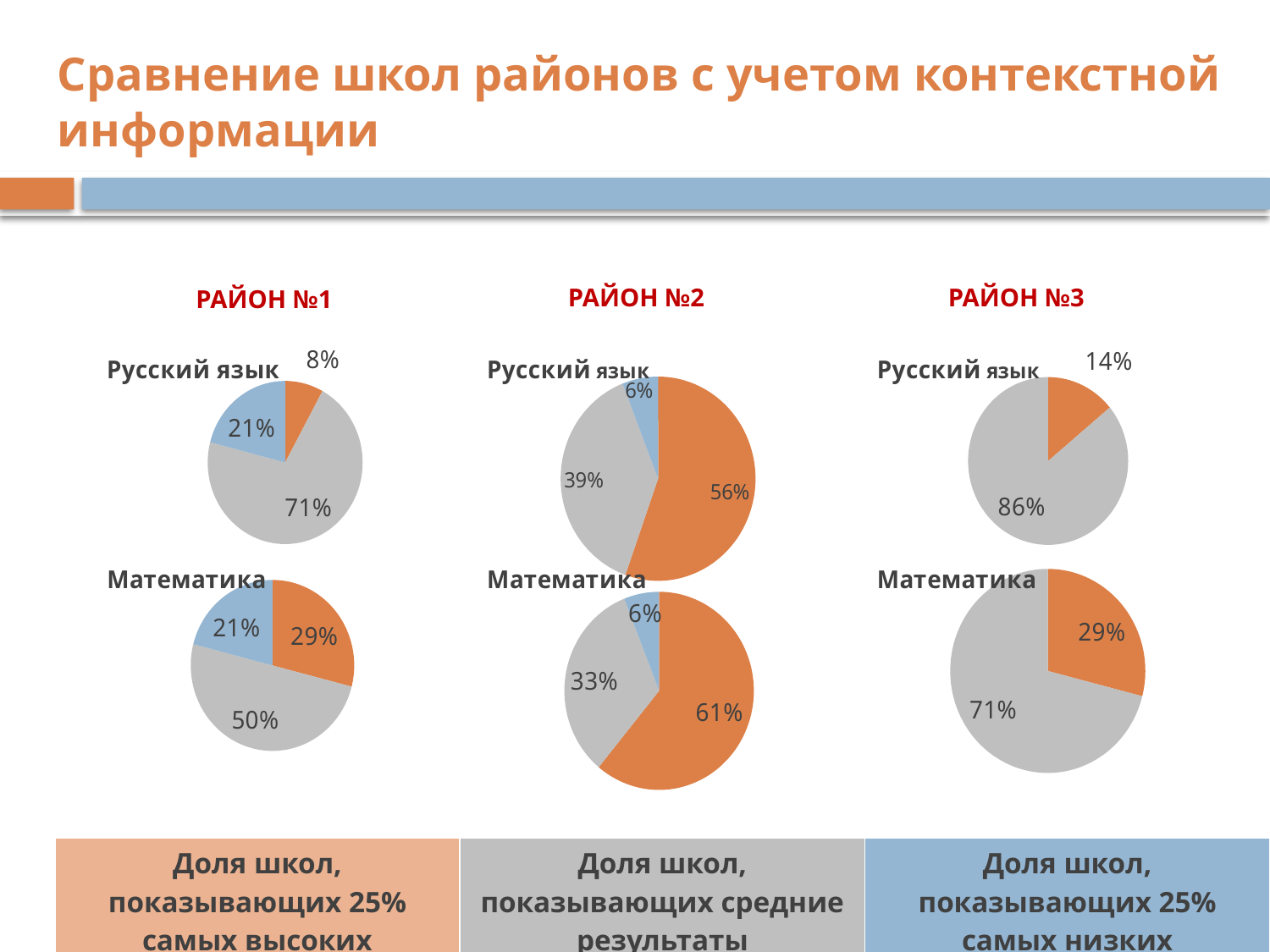
How many slices does the 'Русский язык' pie chart for РАЙОН №3 have? 2 In the 'Математика' pie chart for РАЙОН №1, what share of schools shows average results (grey slice)? 50% What is the difference between the grey slice in the 'Русский язык' chart for РАЙОН №3 and the grey slice in the 'Математика' chart for РАЙОН №3? 15% In the 'Русский язык' pie chart for РАЙОН №2, what share of schools shows the 25% highest results (orange slice)? 56% What type of charts are shown on the slide? Pie charts In the 'Русский язык' pie chart for РАЙОН №1, which slice is the smallest? 8% (orange, 25% highest results) In the 'Русский язык' pie chart for РАЙОН №3, what share of schools shows average results (grey slice)? 86% Which is larger: the orange slice in the 'Русский язык' chart for РАЙОН №2 or the orange slice in the 'Русский язык' chart for РАЙОН №3? РАЙОН №2 (56%) In the 'Математика' pie chart for РАЙОН №2, which slice is the largest? 61% (orange, 25% highest results)